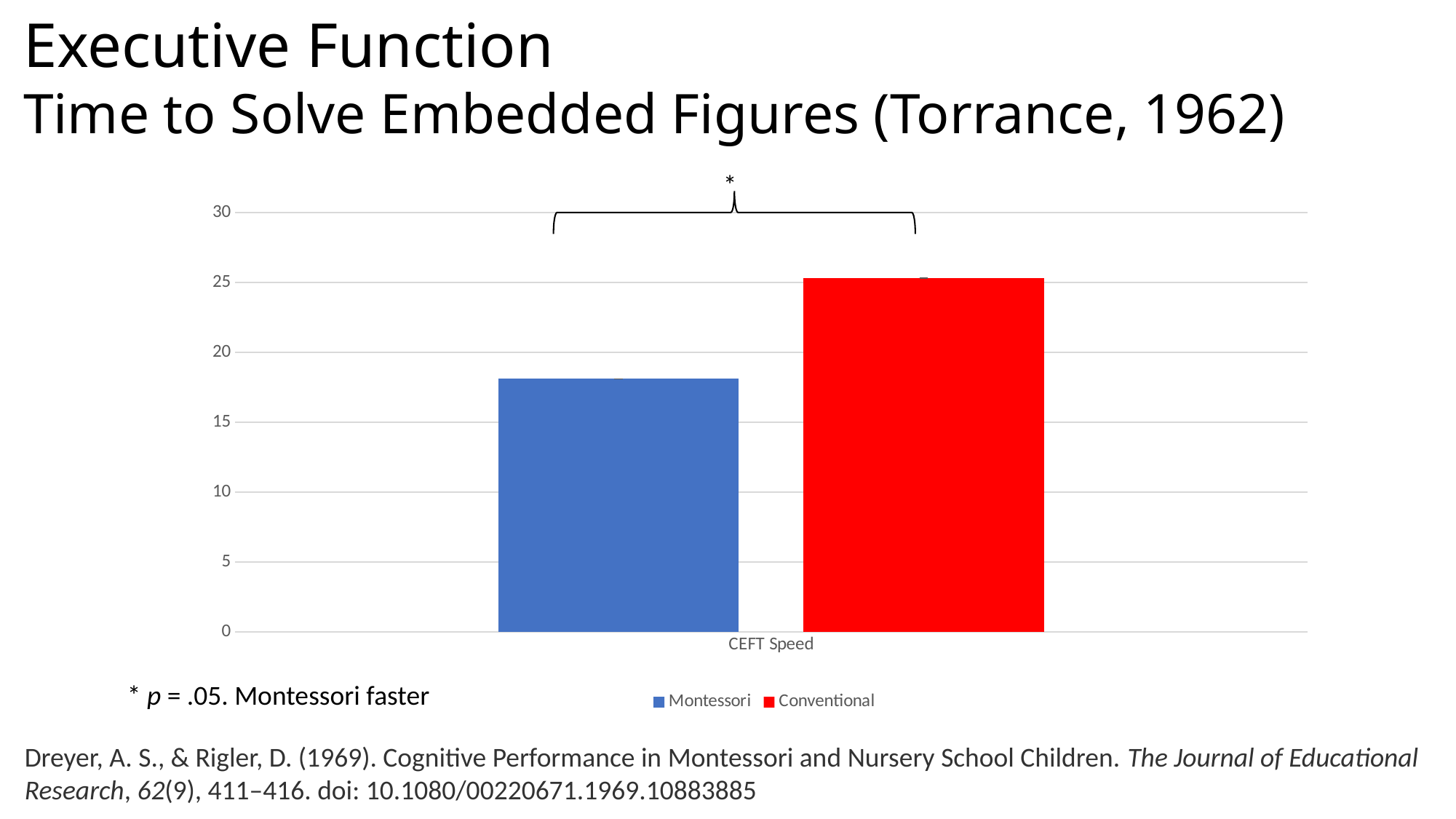
What is the highest value shown on the y axis? 30 What is the category label on the x axis? CEFT Speed What kind of chart is shown on the slide? bar chart Is the value for Montessori greater or less than 20? less What colour is the Conventional bar? red Is the value for Montessori greater or less than 15? greater How many series does the legend list? 2 Which series has the lowest bar? Montessori Which series has the higher CEFT Speed value, Montessori or Conventional? Conventional Is the value for Conventional greater or less than 30? less How many bars are plotted in the chart? 2